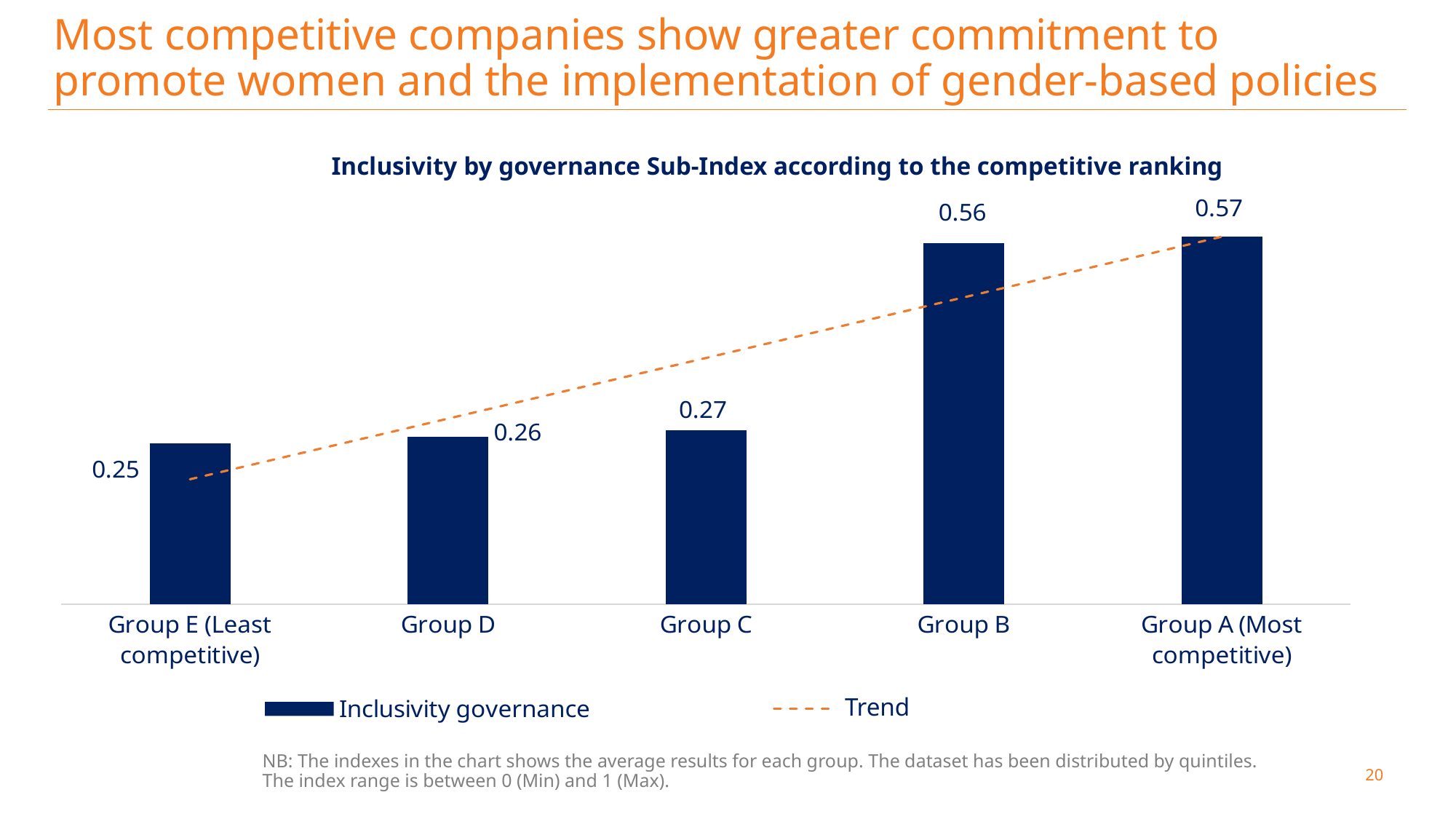
How many series does the chart legend list? 2 What is the Inclusivity governance value for Group E (Least competitive)? 0.25 What is the Inclusivity governance value for Group C? 0.27 Do the Inclusivity governance values rise or fall from Group E (Least competitive) to Group A (Most competitive)? Rise What kind of chart is used to show the Inclusivity governance values? Bar chart What is the difference between the Inclusivity governance values for Group B and Group C? 0.29 How many groups are shown on the x axis of the chart? 5 What is the difference between the Inclusivity governance values for Group A (Most competitive) and Group E (Least competitive)? 0.32 What is the Inclusivity governance value for Group B? 0.56 Which has a larger Inclusivity governance value, Group D or Group B? Group B Which group has the lowest Inclusivity governance value? Group E (Least competitive) Which group has the highest Inclusivity governance value? Group A (Most competitive)